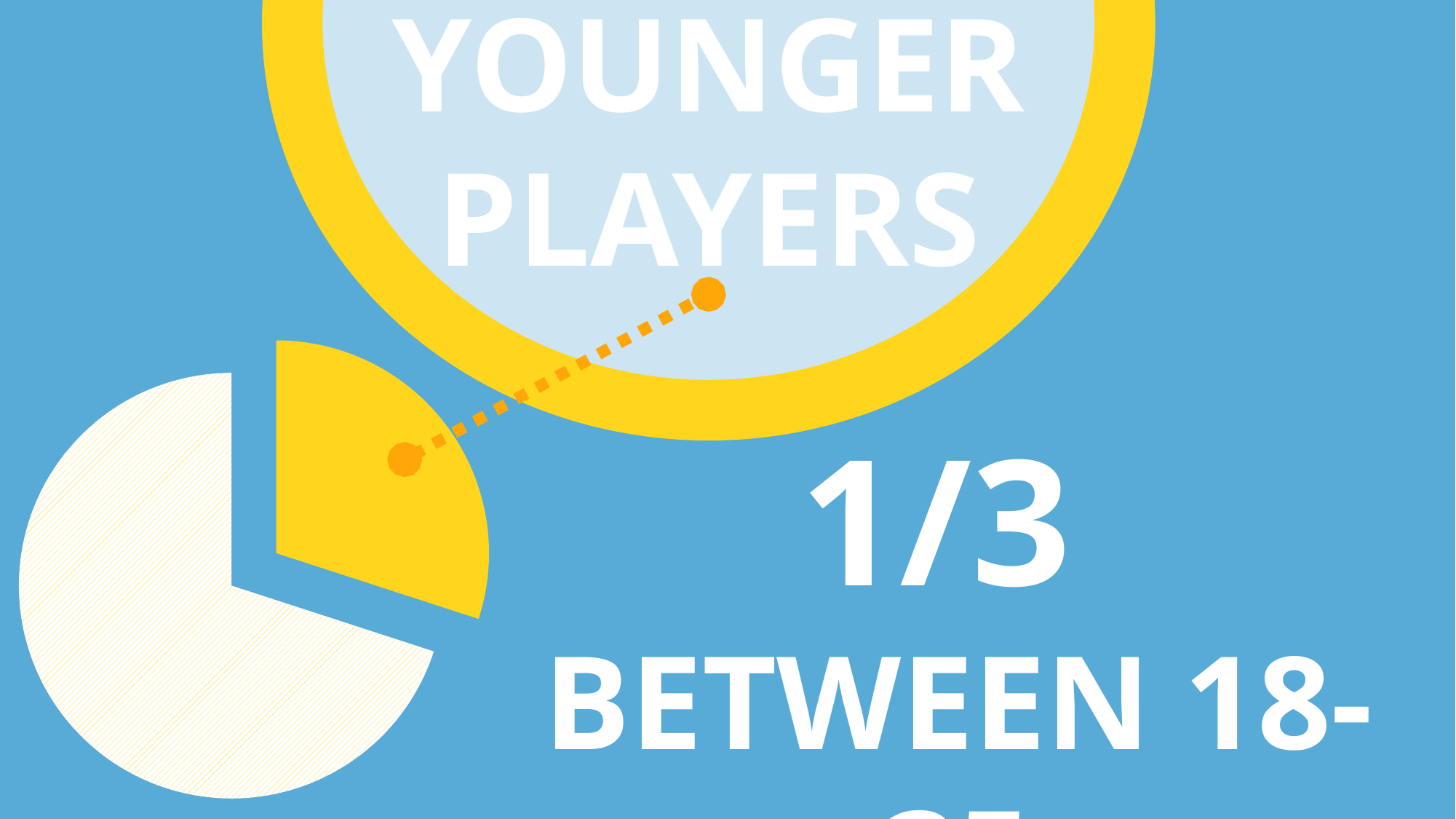
According to the slide, what share of players does the yellow slice of the pie chart represent? 1/3 Which slice of the pie chart is larger, the yellow slice or the white hatched slice? the white hatched slice What heading is shown in the circle above the pie chart? YOUNGER PLAYERS What kind of chart is shown on the slide? pie chart Which slice of the pie chart is the smallest? the yellow slice How many slices does the pie chart have? 2 Which slice of the pie chart is pulled out (exploded) from the rest of the pie? the yellow slice Which slice of the pie chart is the largest? the white hatched slice Is the yellow slice of the pie chart greater or less than half of the pie? less